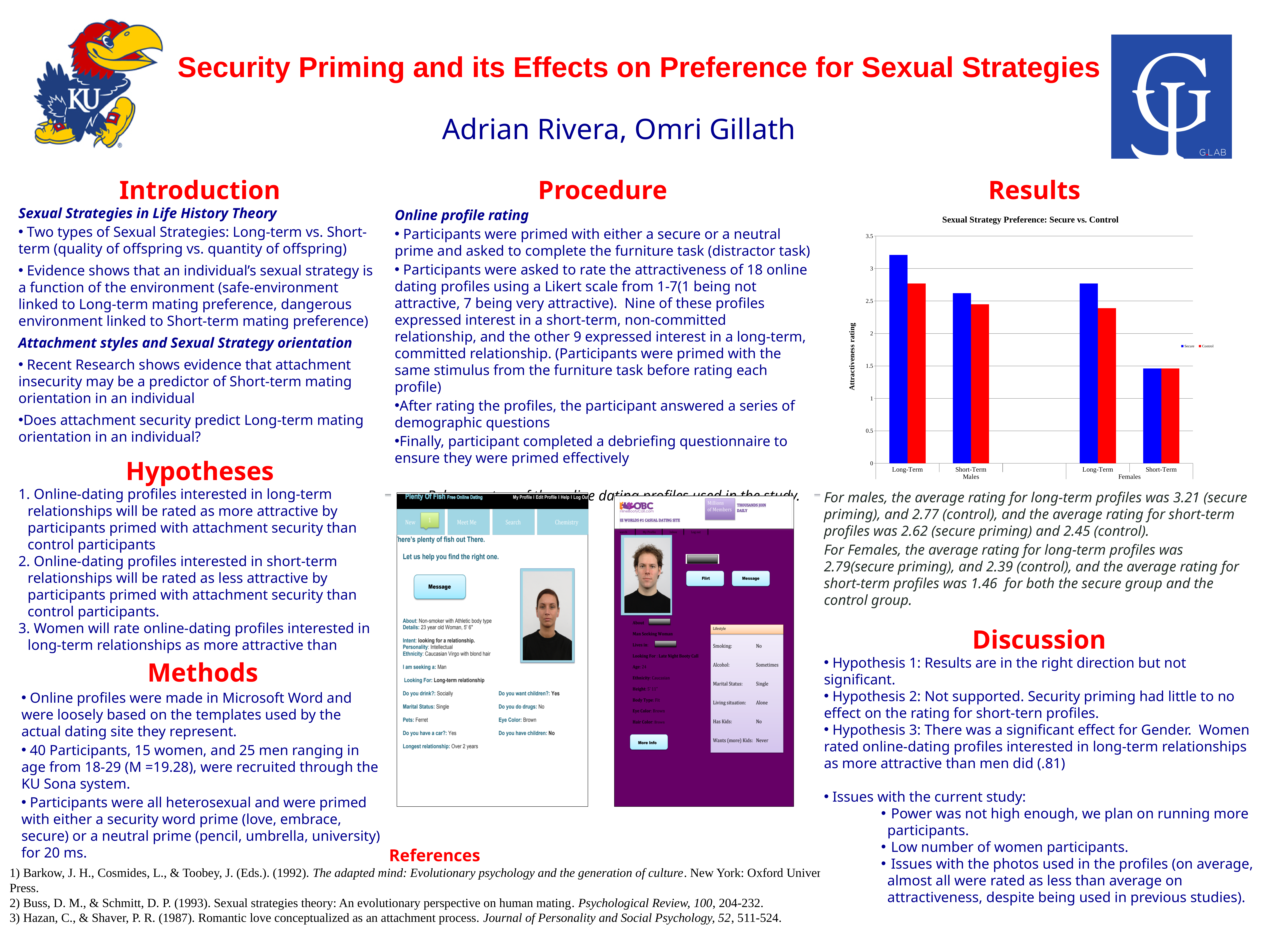
How many categories are shown along the x axis of the Results chart? 4 What is the title of the chart in the Results section? Sexual Strategy Preference: Secure vs. Control How many series does the legend of the Results chart list? 2 Which category has the highest Secure bar in the Results chart? Long-Term (Males) In the Results chart, is the Control value for Short-Term Females greater or less than 2? less Which category has the lowest Secure bar in the Results chart? Short-Term (Females) What kind of chart is shown in the Results section? bar chart In the Results chart, is the Secure value for Long-Term Males greater or less than 3? greater According to the Results, what was the average rating for long-term profiles by males with secure priming? 3.21 In the Results chart, is the Secure or the Control bar larger for Long-Term Males? Secure What are the two series named in the legend of the Results chart? Secure and Control According to the Results, what is the difference between the secure priming (3.21) and control (2.77) ratings for long-term profiles among males? 0.44